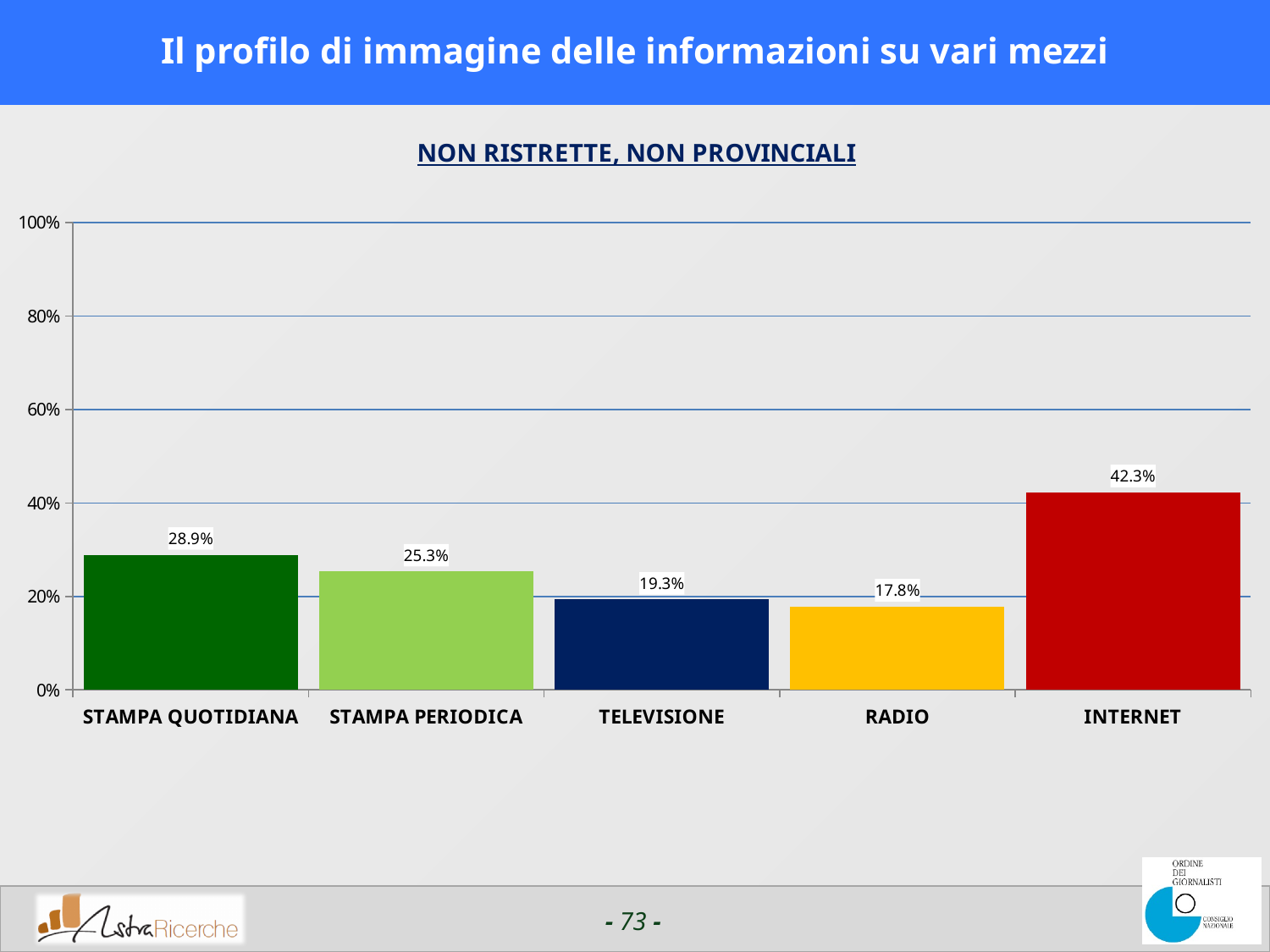
What is the value for STAMPA QUOTIDIANA? 28.9% Which is larger, the value for STAMPA PERIODICA or the value for TELEVISIONE? STAMPA PERIODICA What is the difference between the values for INTERNET and STAMPA QUOTIDIANA? 13.4% What is the value for TELEVISIONE? 19.3% What is the subtitle shown above the chart? NON RISTRETTE, NON PROVINCIALI What is the value for INTERNET? 42.3% What is the value for RADIO? 17.8% Which category has the highest value? INTERNET How many categories are shown on the x axis? 5 Which category has the lowest value? RADIO What kind of chart is shown on the slide? bar chart Is the value for INTERNET greater or less than 40%? greater